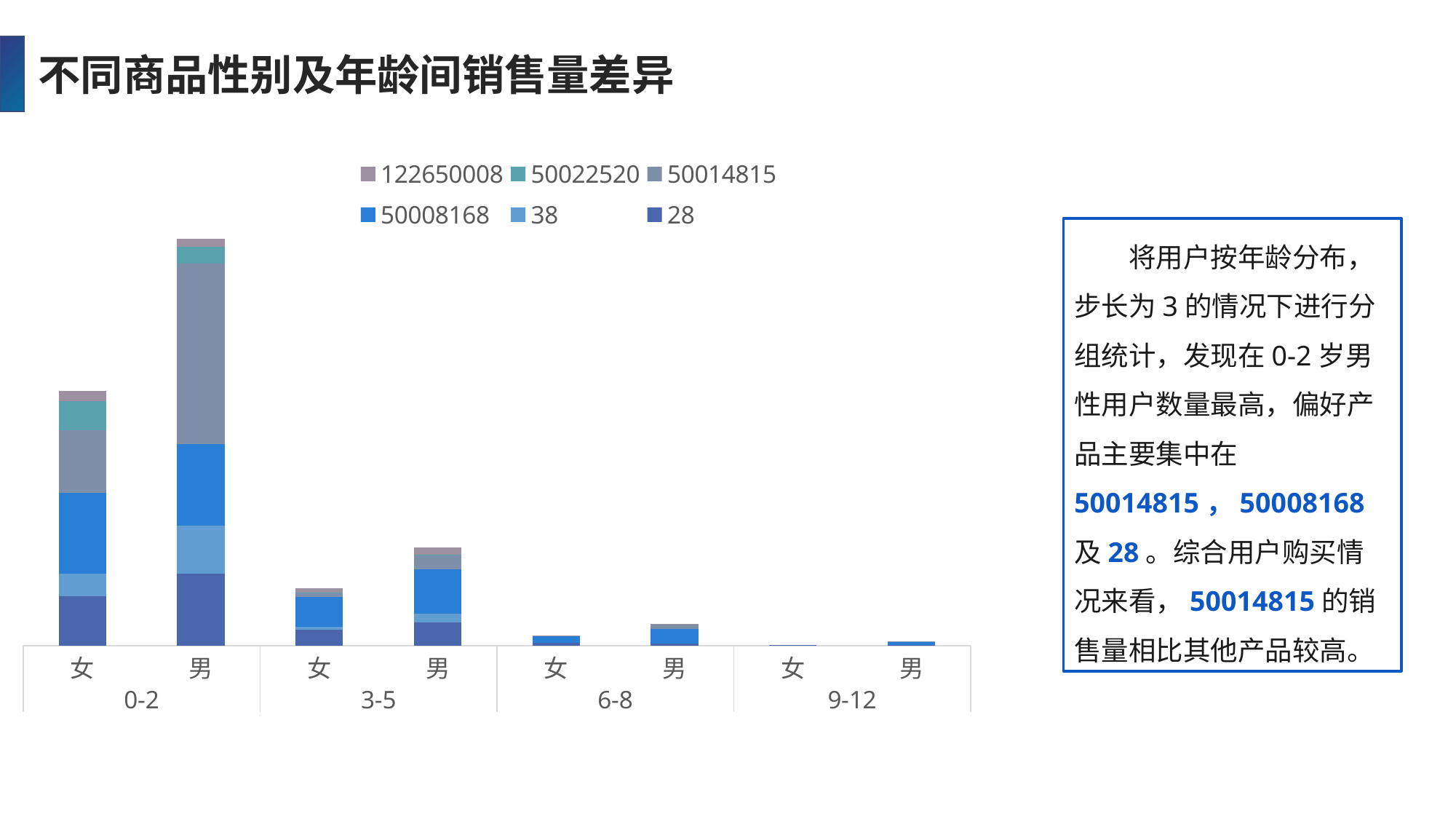
Which legend entry is shown with the purple-grey colour at the top of the stacked bars? 122650008 How many series does the chart legend list? 6 What kind of chart is shown on the slide? Stacked bar chart Which bar is the tallest in the chart? 男 in the 0-2 age group Which is taller, the 男 bar in the 0-2 group or the 男 bar in the 3-5 group? 男 in the 0-2 group Do the bar heights generally rise or fall as the age groups increase from 0-2 to 9-12? Fall In the 0-2 age group, which bar is taller, 女 or 男? 男 How many bars are plotted in the chart? 8 Which bar is the shortest in the chart? 女 in the 9-12 age group How many age groups are shown on the x axis of the chart? 4 What is the title of the chart slide? 不同商品性别及年龄间销售量差异 In the 3-5 age group, which bar is taller, 女 or 男? 男